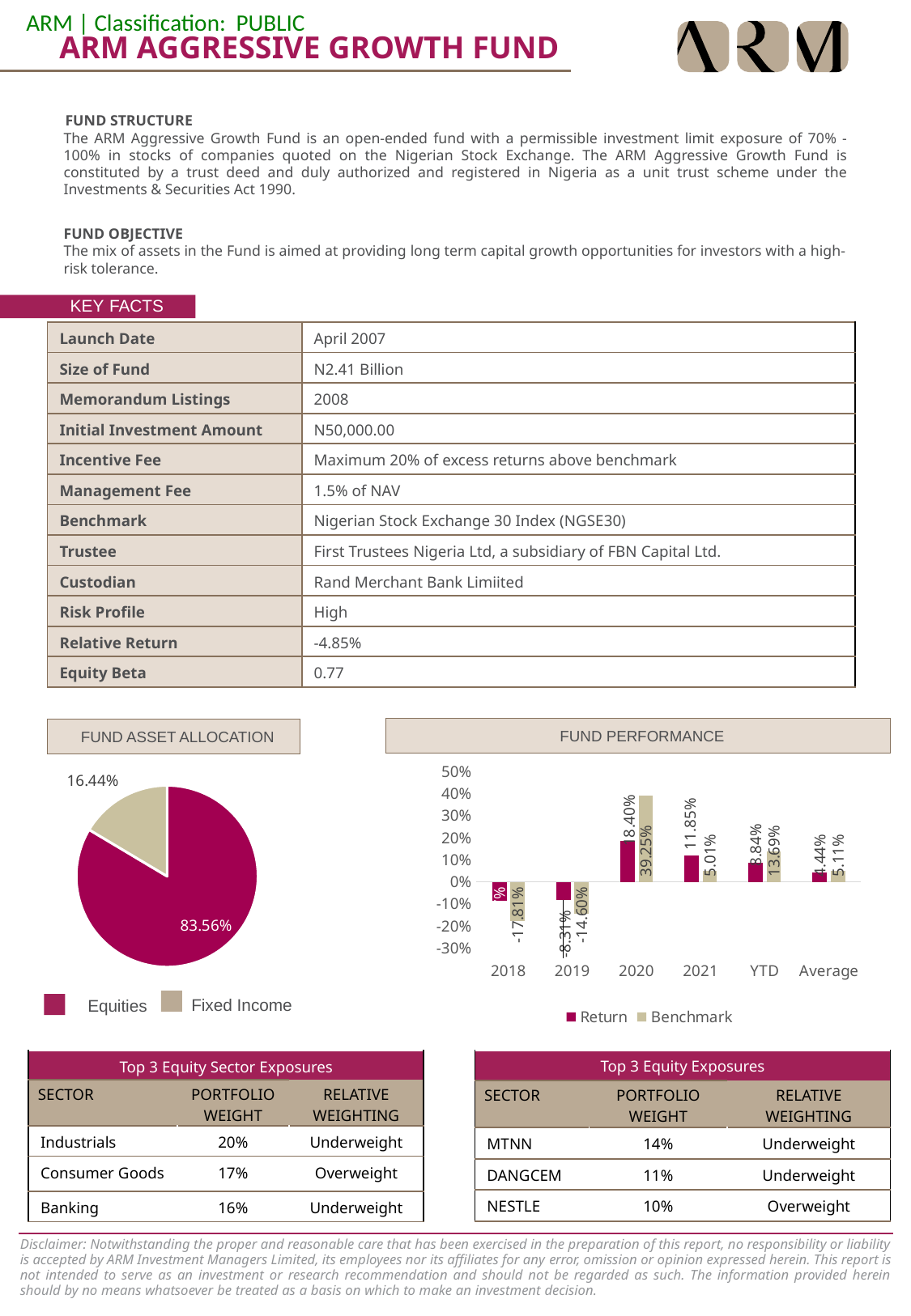
How many series does the legend of the FUND PERFORMANCE chart list? 2 In the FUND PERFORMANCE chart, which period has the highest Benchmark value? 2020 How many periods are shown on the x axis of the FUND PERFORMANCE chart? 6 In the FUND ASSET ALLOCATION chart, what percentage of the fund is allocated to Fixed Income? 16.44% In the FUND ASSET ALLOCATION chart, what percentage of the fund is allocated to Equities? 83.56% What kind of chart is the FUND ASSET ALLOCATION chart? Pie chart What kind of chart is the FUND PERFORMANCE chart? Bar chart In the FUND PERFORMANCE chart, what is the Return value for 2021? 11.85% In the FUND PERFORMANCE chart, what is the Benchmark value for 2018? -17.81% In the FUND PERFORMANCE chart, what is the difference between the Return and Benchmark values for 2021? 6.84 percentage points In the FUND ASSET ALLOCATION chart, which slice is larger, Equities or Fixed Income? Equities In the FUND PERFORMANCE chart, what is the Benchmark value for 2020? 39.25%